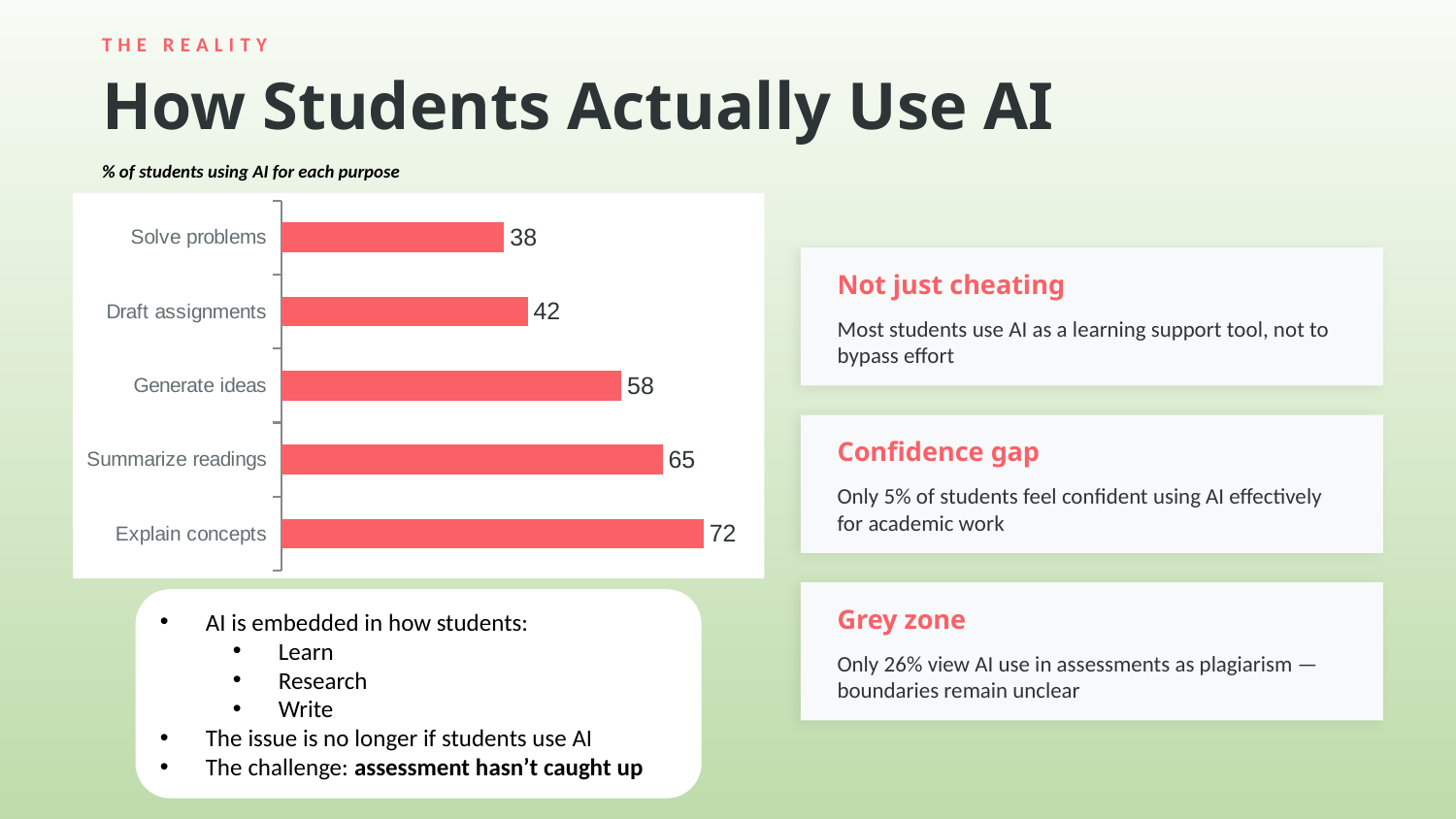
How many purposes (categories) are shown in the chart? 5 What is the difference between the values for Generate ideas and Draft assignments? 16 What colour are the bars in the chart? Red What is the value shown for Draft assignments? 42 What kind of chart is shown on the slide? Bar chart What is the subtitle describing what the chart measures? % of students using AI for each purpose Which is larger, the value for Summarize readings or the value for Generate ideas? Summarize readings What is the difference between the values for Explain concepts and Solve problems? 34 Which purpose has the lowest percentage of students using AI? Solve problems What is the value shown for Summarize readings? 65 What percentage of students use AI to explain concepts? 72 Which purpose has the highest percentage of students using AI? Explain concepts